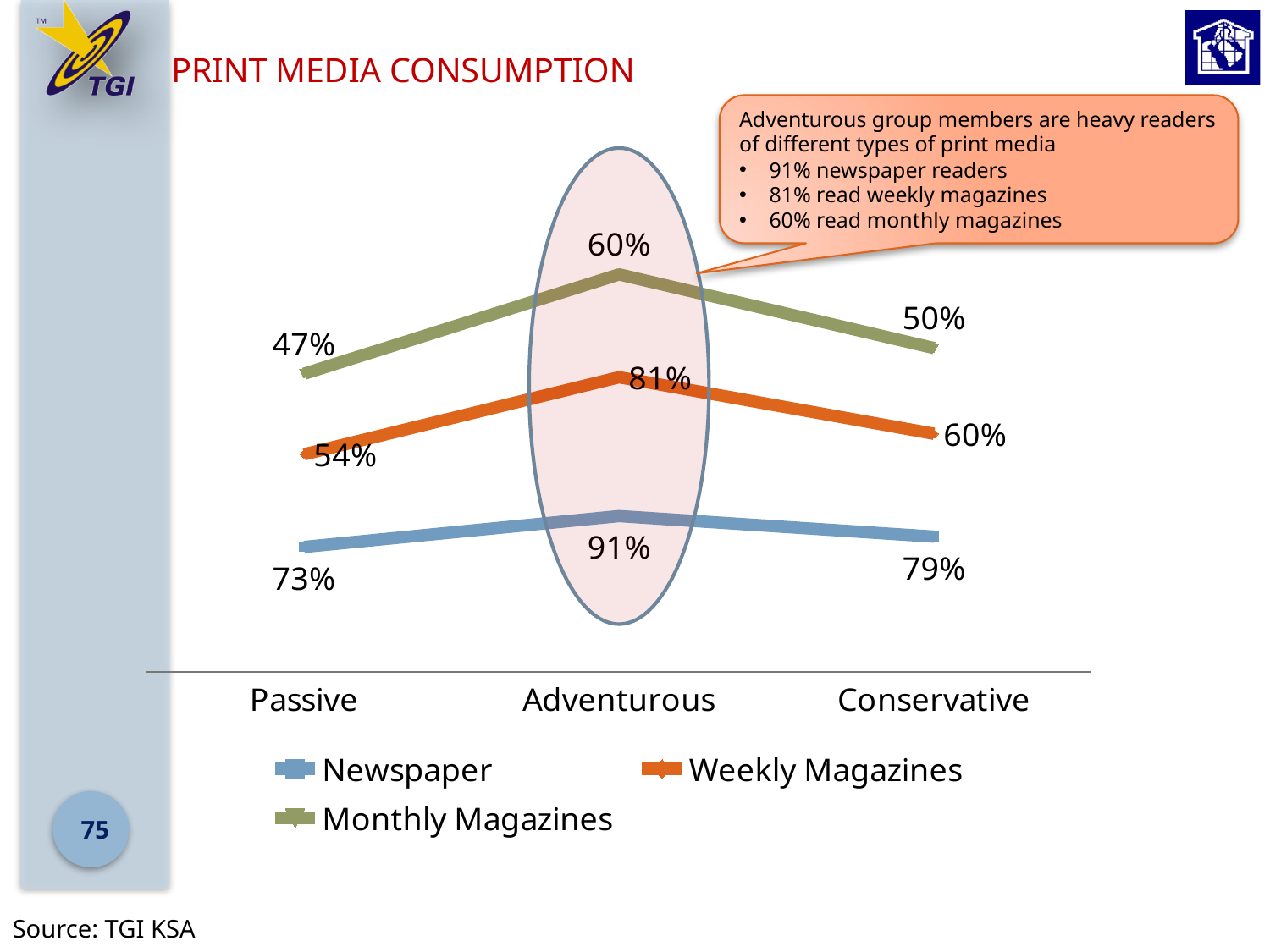
How many groups are shown on the x axis? 3 What is the Monthly Magazines value for the Conservative group? 50% Which group has the lowest Monthly Magazines value? Passive What type of chart is shown on the slide? Line chart Which group has the highest Weekly Magazines value? Adventurous Which is larger: the Weekly Magazines value for Conservative or the Weekly Magazines value for Passive? Conservative What is the Newspaper value for the Conservative group? 79% What is the title of the chart? PRINT MEDIA CONSUMPTION What is the difference between the Newspaper values for the Adventurous and Passive groups? 18% What is the Newspaper value for the Adventurous group? 91% How many series does the legend list? 3 What is the Weekly Magazines value for the Passive group? 54%